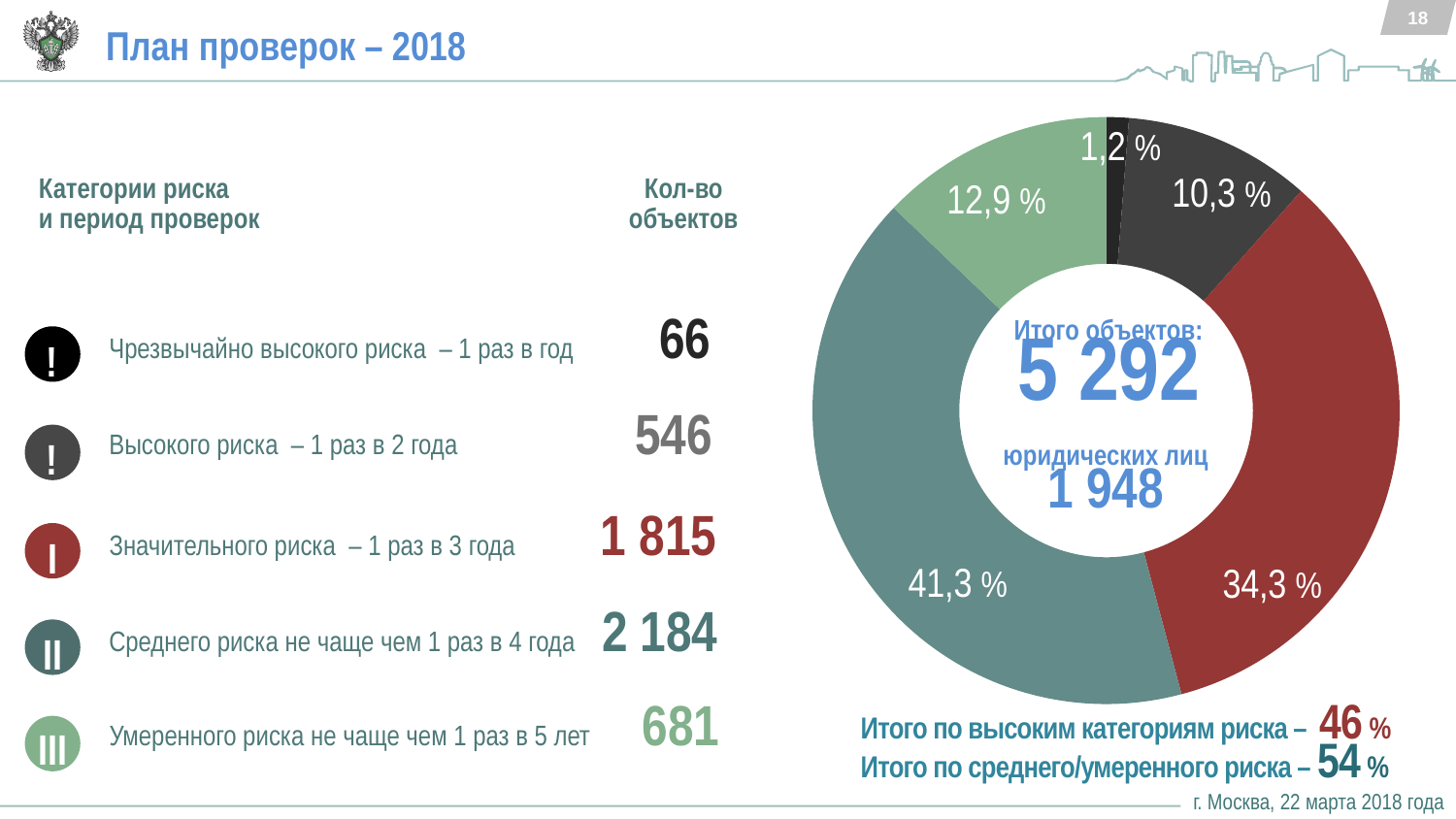
What number of legal entities (юридических лиц) is shown in the centre of the donut chart? 1 948 Which slice is larger in the donut chart: the light green one (12,9 %) or the dark grey one (10,3 %)? the light green one (12,9 %) What is the difference between the 41,3 % slice and the 34,3 % slice in the donut chart? 7 % What percentage is shown for the red slice (Значительного риска) in the donut chart? 34,3 % What kind of chart is shown on the slide? pie chart (donut) Which slice of the donut chart is the smallest? 1,2 % (Чрезвычайно высокого риска) What is the combined share for the high risk categories (Итого по высоким категориям риска) stated below the chart? 46 % How many slices does the donut chart have? 5 What percentage is shown for the dark grey slice (Высокого риска) in the donut chart? 10,3 % Which slice of the donut chart is the largest? 41,3 % (Среднего риска) What percentage is shown for the light green slice (Умеренного риска) in the donut chart? 12,9 % What total number of objects (Итого объектов) is shown in the centre of the donut chart? 5 292